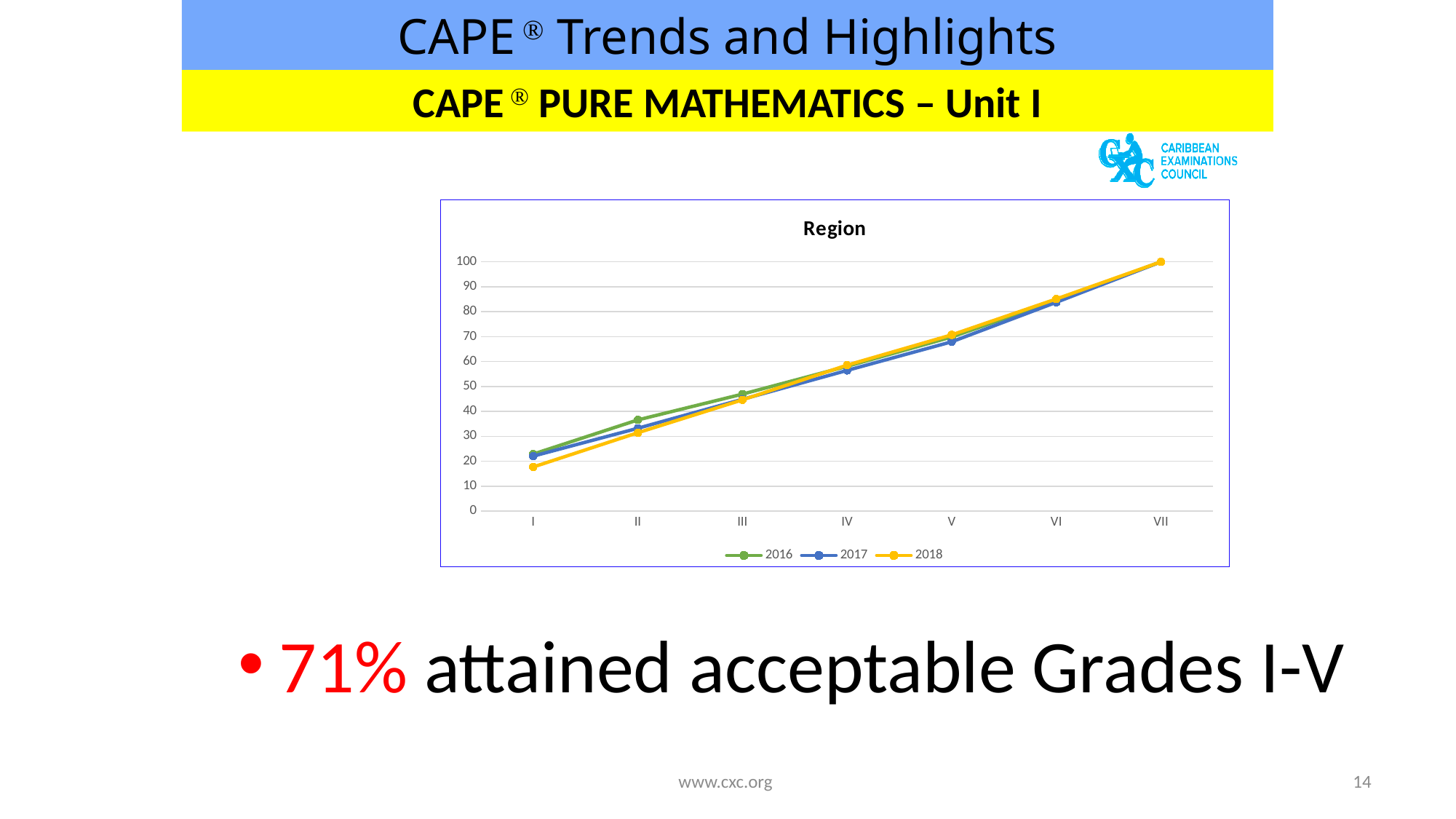
How many categories are shown along the x axis of the chart? 7 What kind of chart is shown on the slide? line chart At grade I, which series has the larger value, 2016 or 2018? 2016 Which grade has the highest value for the 2017 series? VII Which years are listed in the chart's legend? 2016, 2017, 2018 How many series does the legend of the chart list? 3 Do the values for the 2018 series rise or fall from grade I to grade VII? rise What is the title of the chart? Region Which grade has the lowest value for the 2018 series? I Is the value for the 2016 series at grade V greater or less than 60? greater What is the value for the 2016 series at grade VII? 100 Is the value for the 2018 series at grade I greater or less than 20? less